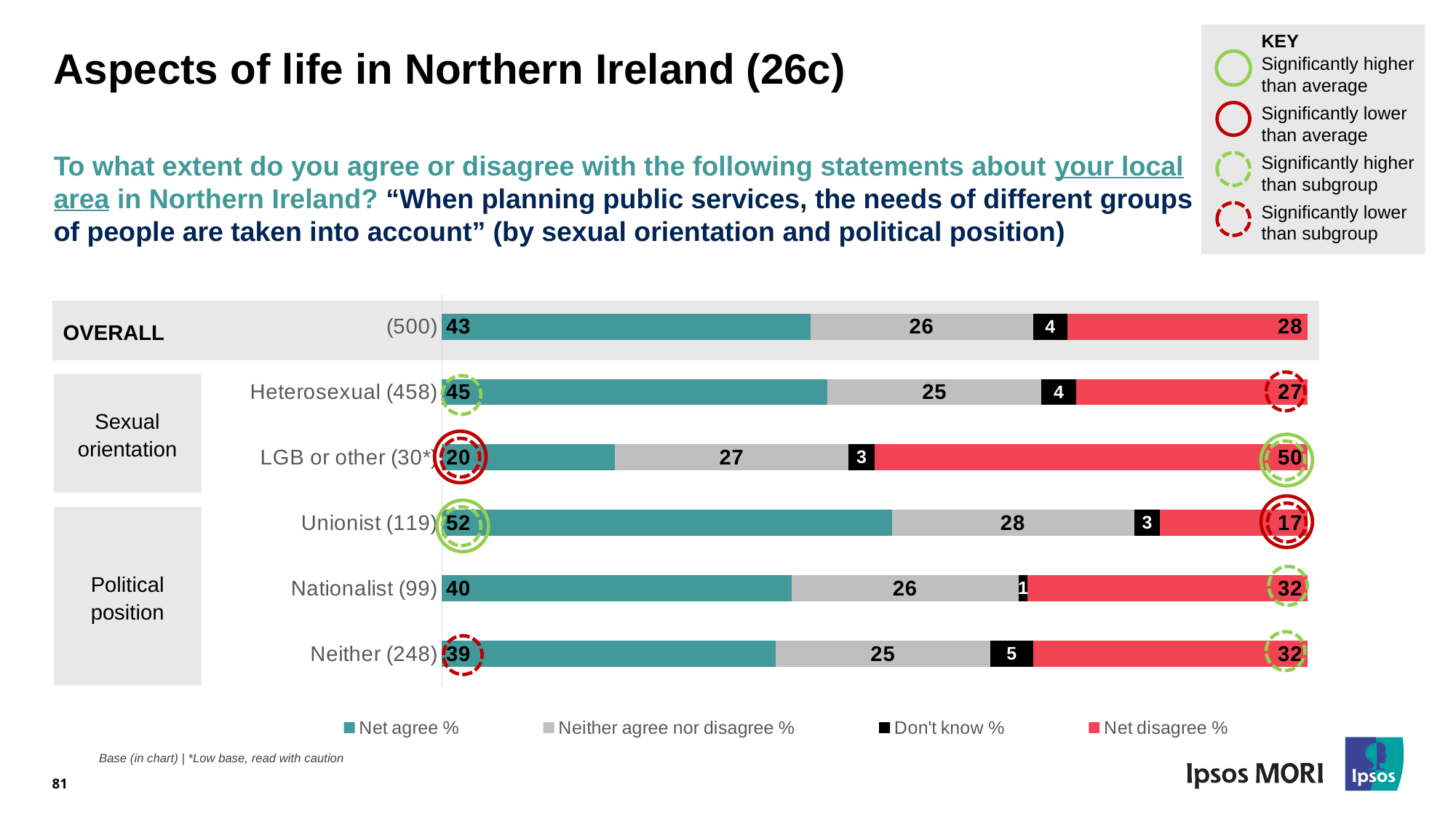
How many series does the legend list? 4 What is the Neither agree nor disagree % for the OVERALL (500) bar? 26 What is the Net disagree % for LGB or other (30*)? 50 How many category bars are shown in the chart? 6 Which category has the lowest Net disagree %? Unionist (119) What is the Don't know % for Neither (248)? 5 What is the total of the Nationalist (99) stacked bar? 99 Which is larger: the Net disagree % for Nationalist (99) or for Heterosexual (458)? Nationalist (99) Which category has the highest Net agree %? Unionist (119) What is the Net agree % for Unionist (119)? 52 What kind of chart is shown on the slide? Stacked bar chart What is the difference between the Net agree % for Heterosexual (458) and LGB or other (30*)? 25